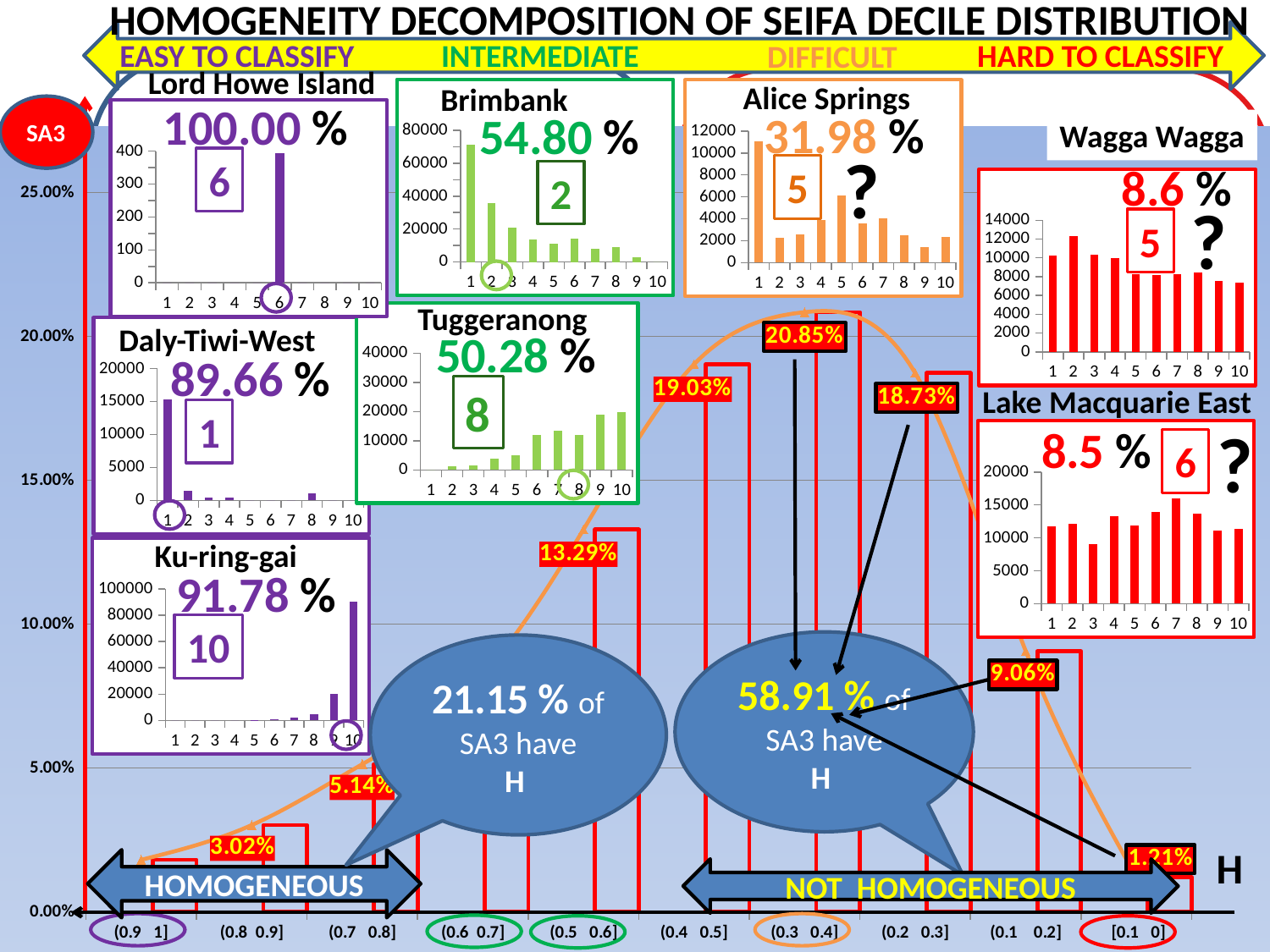
In the Ku-ring-gai chart, which decile has the highest bar? 10 In the Lord Howe Island chart, which decile has the highest bar? 6 In the Alice Springs chart, which decile has the highest bar? 1 In the Lake Macquarie East chart, which decile has the lowest bar? 3 In the Lake Macquarie East chart, is the value for decile 3 greater or less than 10000? less How many deciles are plotted on the x axis of the Brimbank chart? 10 In the Tuggeranong chart, do the values generally rise or fall from decile 1 to decile 10? rise In the Brimbank chart, is the value for decile 1 greater or less than 60000? greater What kind of chart is the Lord Howe Island inset? bar chart